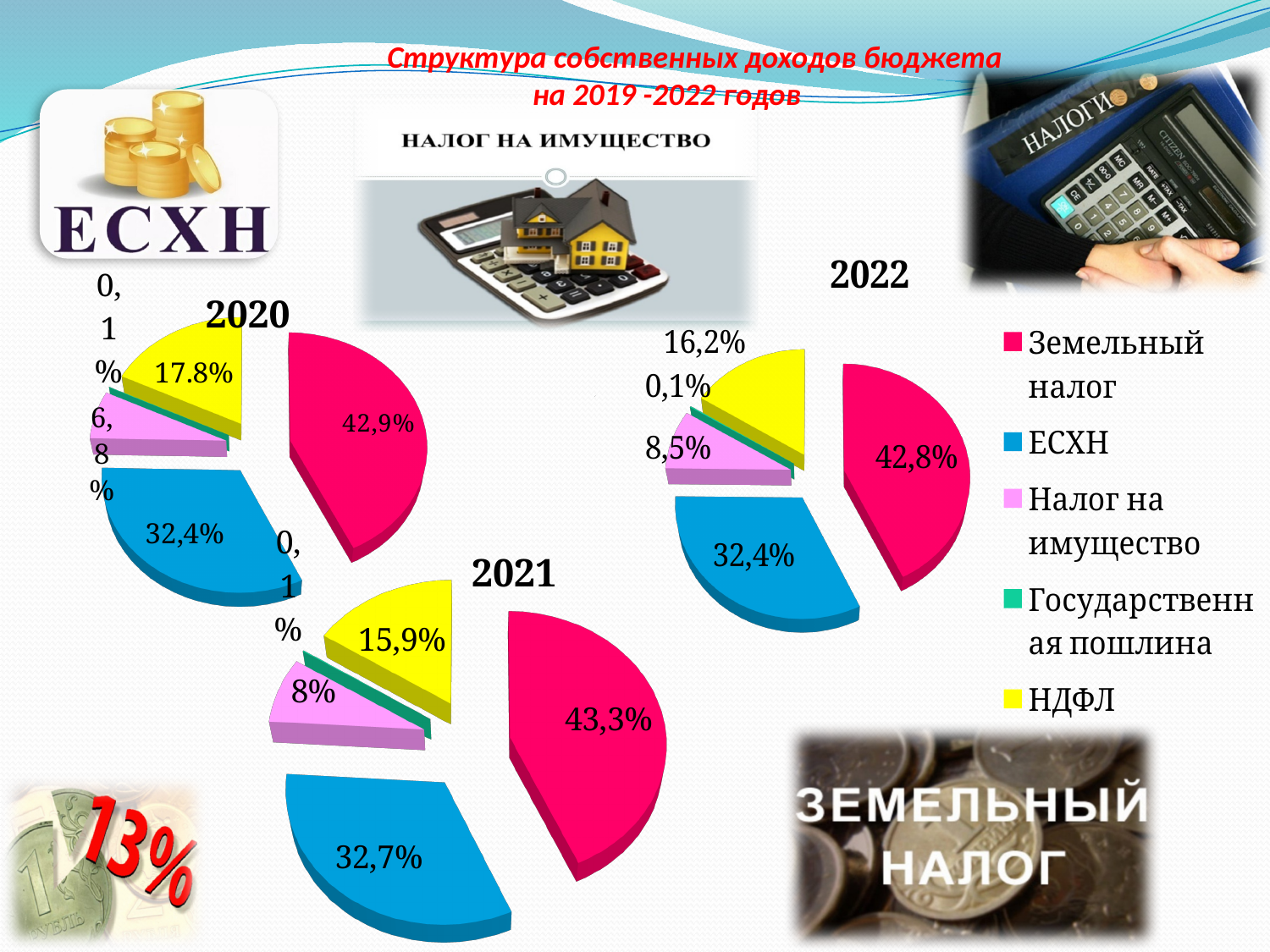
How many categories does the legend list for the pie charts? 5 What kind of charts are shown on the slide? Pie charts In the 2022 pie chart, what is the difference between the shares of Земельный налог and ЕСХН? 10,4% How many pie charts are on the slide? 3 In the 2020 pie chart, which category has the smallest share? Государственная пошлина In the 2021 pie chart, which category has the largest share? Земельный налог In the 2021 pie chart, what share does ЕСХН have? 32,7% In the 2022 pie chart, what share does Налог на имущество have? 8,5% In the 2020 pie chart, what share does Земельный налог have? 42,9% In the 2022 pie chart, what share does НДФЛ have? 16,2% Which colour represents ЕСХН in the pie charts? Blue In the 2021 pie chart, which is larger: the share of НДФЛ or the share of Налог на имущество? НДФЛ